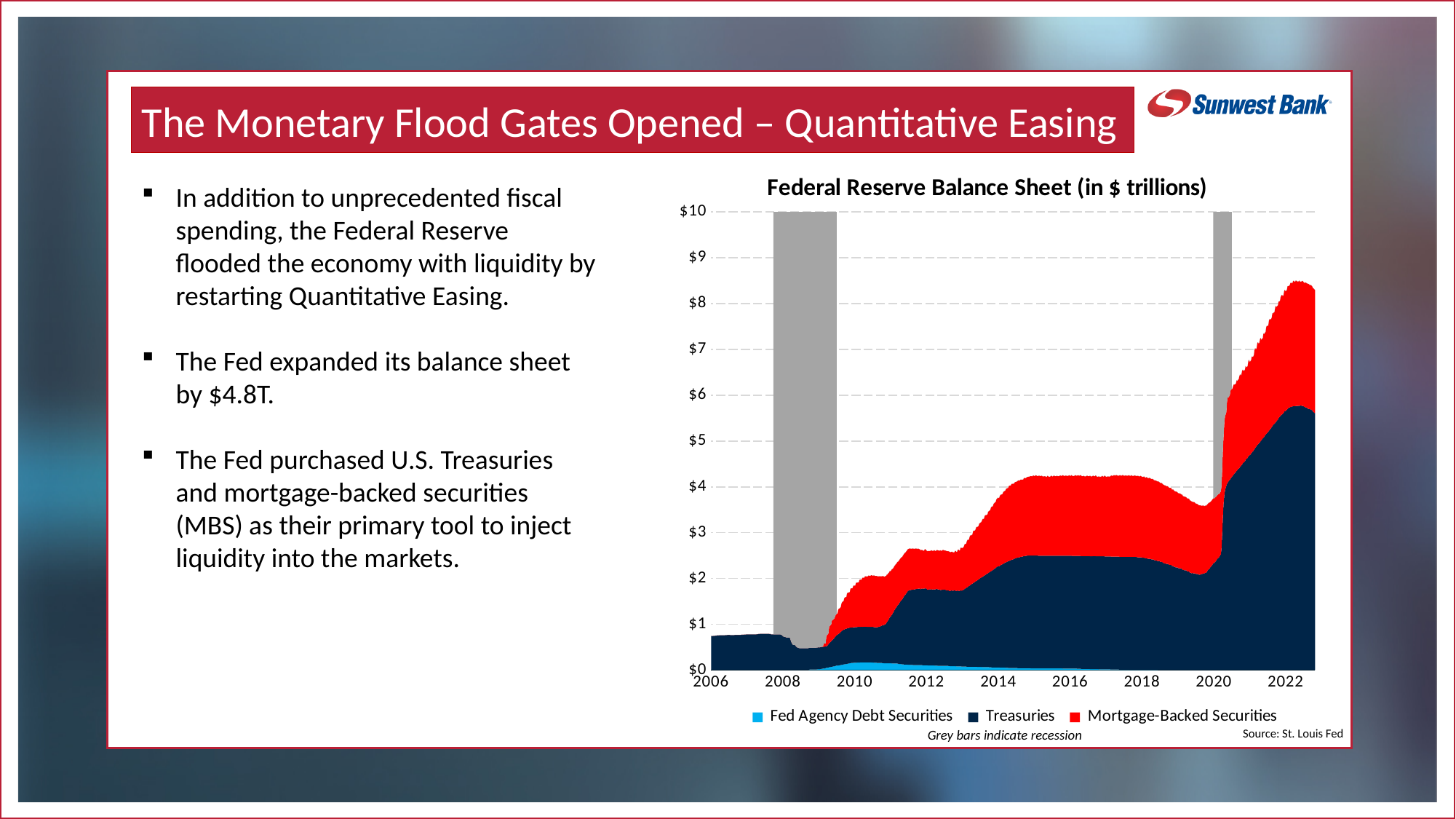
Which series makes up the largest part of the balance sheet in 2022? Treasuries Does the total balance sheet rise or fall between 2020 and 2022? Rises Is the total Federal Reserve balance sheet in 2006 greater or less than $1 trillion? less What is the title of the chart? Federal Reserve Balance Sheet (in $ trillions) Which is larger, the total balance sheet in 2012 or in 2022? 2022 What kind of chart is shown on the slide? Area chart Is the total Federal Reserve balance sheet in 2022 greater or less than $7 trillion? greater Is the total Federal Reserve balance sheet in 2016 greater or less than $3 trillion? greater According to the note below the chart, what do the grey bars indicate? Recession How many series does the chart's legend list? 3 How many year labels are shown on the x axis? 9